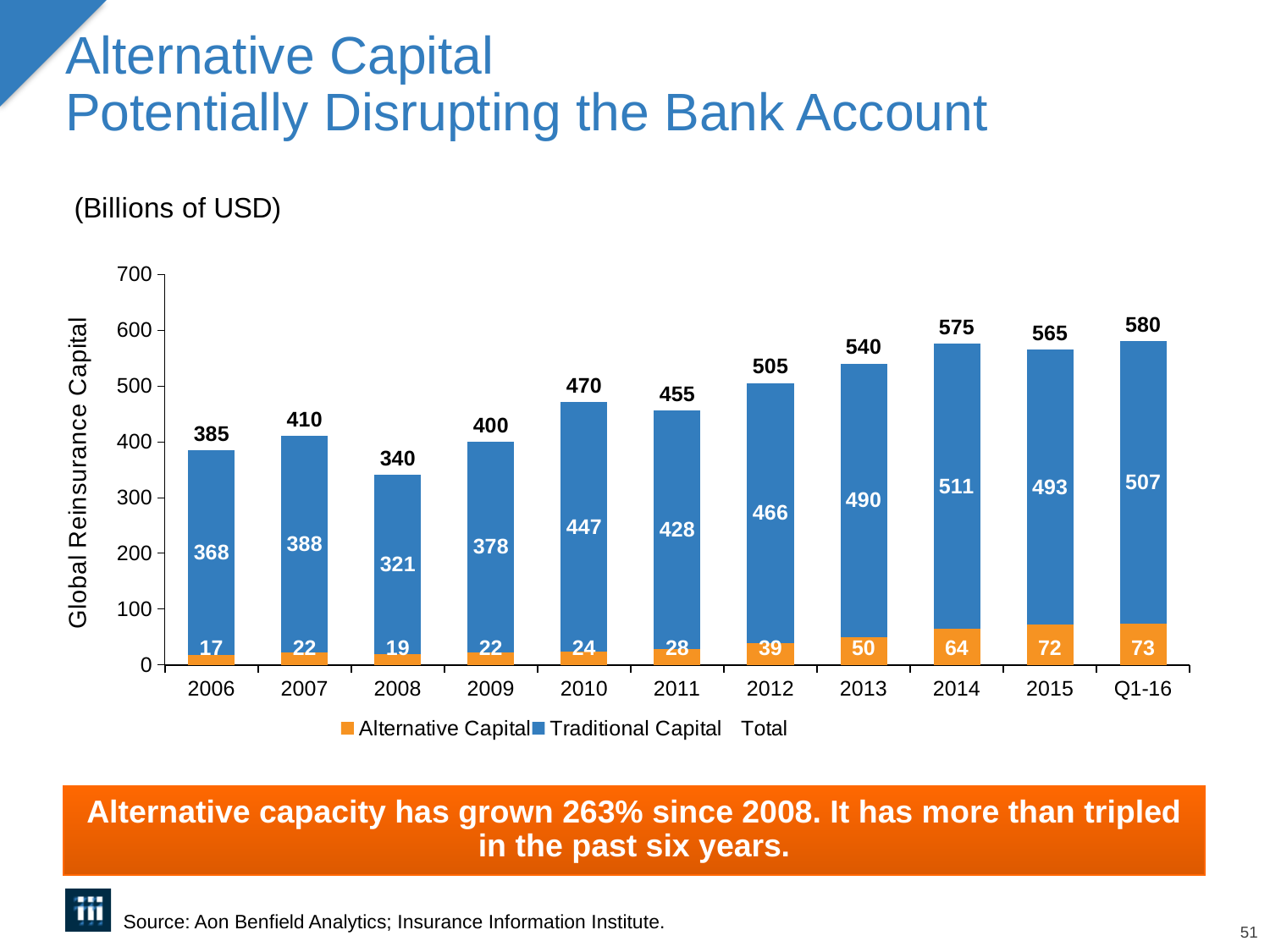
What is the label on the vertical axis? Global Reinsurance Capital What is the Alternative Capital value for 2012? 39 What is the Traditional Capital value for 2014? 511 Which is larger, the Traditional Capital value for 2013 or for 2015? 2015 How many entries does the legend list? 3 What kind of chart is shown on the slide? Stacked bar chart How many time periods are shown on the x axis? 11 Which year has the lowest Total global reinsurance capital? 2008 Which period has the highest Alternative Capital value? Q1-16 What is the difference between the Alternative Capital values for 2015 and 2008? 53 What is the Total value shown for 2008? 340 Is the Total value for 2010 greater or less than 500? less